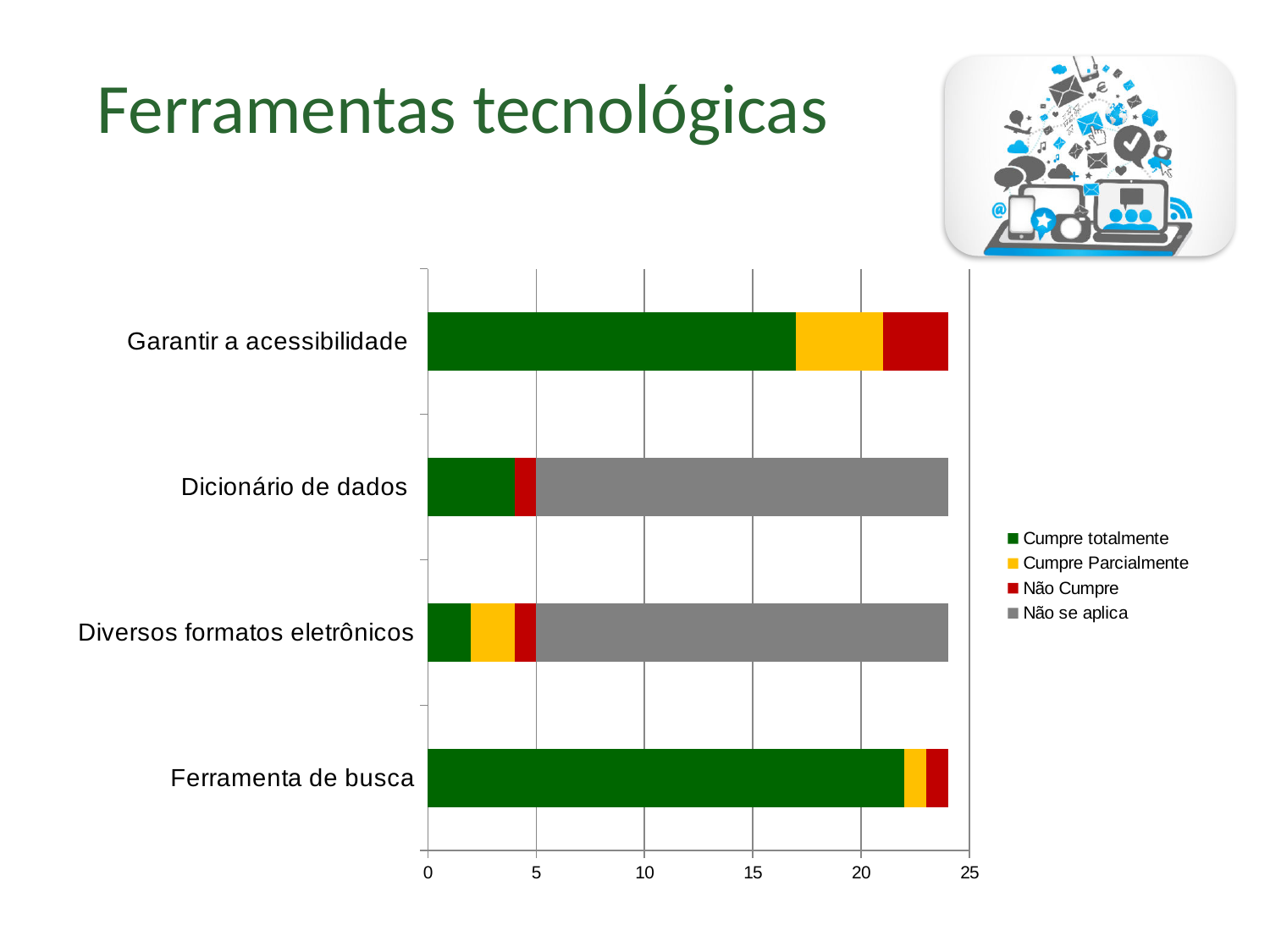
How many categories are plotted on the chart? 4 Which has a larger Cumpre totalmente value, Garantir a acessibilidade or Dicionário de dados? Garantir a acessibilidade Which category has the highest value for Cumpre totalmente? Ferramenta de busca Is the Cumpre totalmente value for Dicionário de dados greater or less than 5? less Which category has the lowest value for Cumpre totalmente? Diversos formatos eletrônicos How many series does the legend list? 4 Which colour represents the Não se aplica series in the legend? Grey Is the Cumpre totalmente value for Garantir a acessibilidade greater or less than 15? greater What is the title of the slide containing the chart? Ferramentas tecnológicas What kind of chart is shown on the slide? Bar chart Is the Cumpre totalmente value for Ferramenta de busca greater or less than 20? greater Which has a larger Não se aplica value, Dicionário de dados or Ferramenta de busca? Dicionário de dados